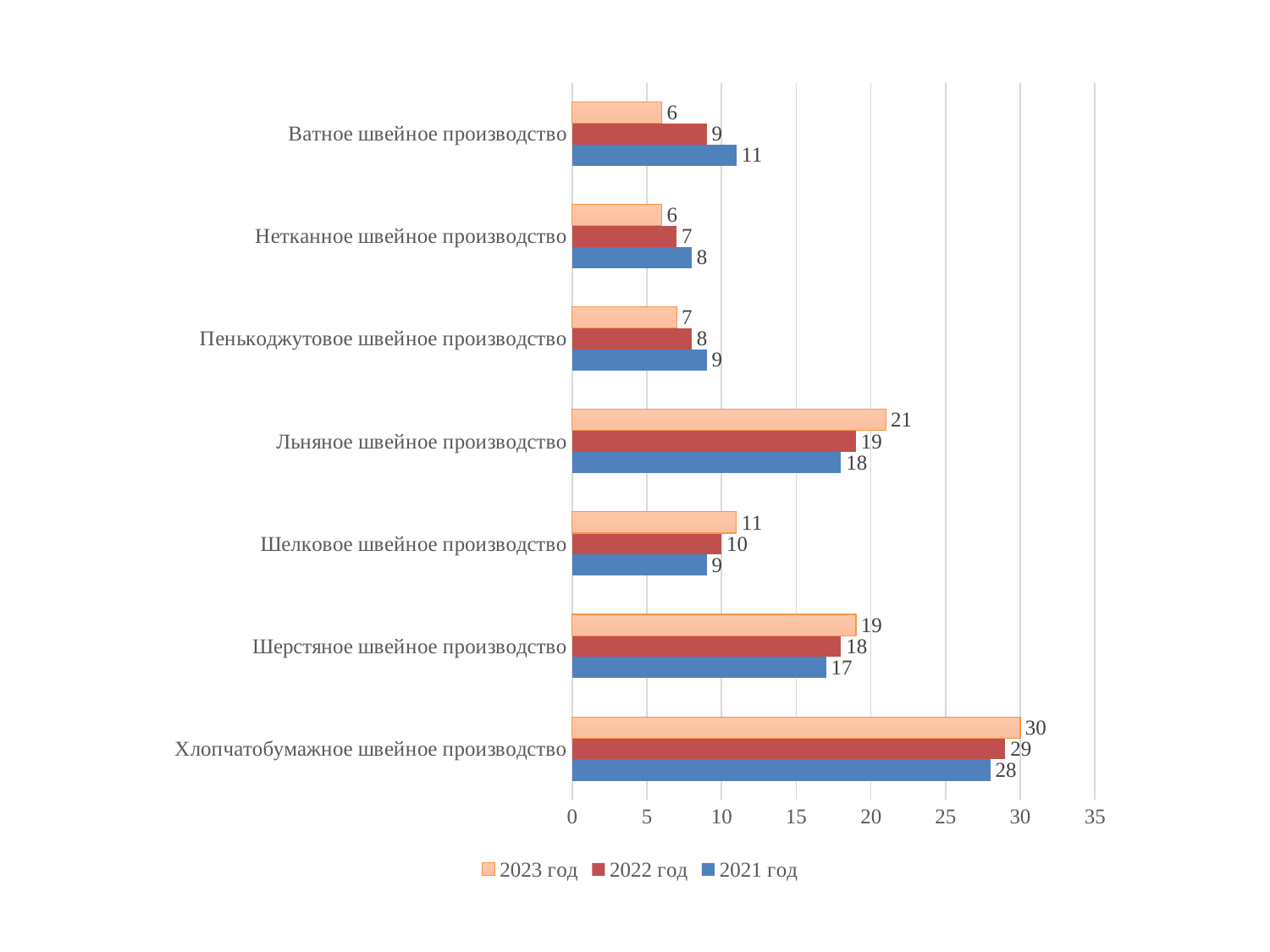
What is the value for Ватное швейное производство in 2021 год? 11 Do the values for Ватное швейное производство rise or fall from 2021 год to 2023 год? Fall How many categories are shown on the chart? 7 What kind of chart is shown on the slide? Bar chart Which category has the highest value in 2023 год? Хлопчатобумажное швейное производство Which category has the lowest value in 2021 год? Нетканное швейное производство Which series is shown in blue in the legend? 2021 год Which is larger for Шелковое швейное производство: the 2023 год value or the 2021 год value? 2023 год What is the difference between the 2023 год and 2021 год values for Льняное швейное производство? 3 What is the value for Льняное швейное производство in 2022 год? 19 What is the value for Хлопчатобумажное швейное производство in 2023 год? 30 How many series does the legend list? 3